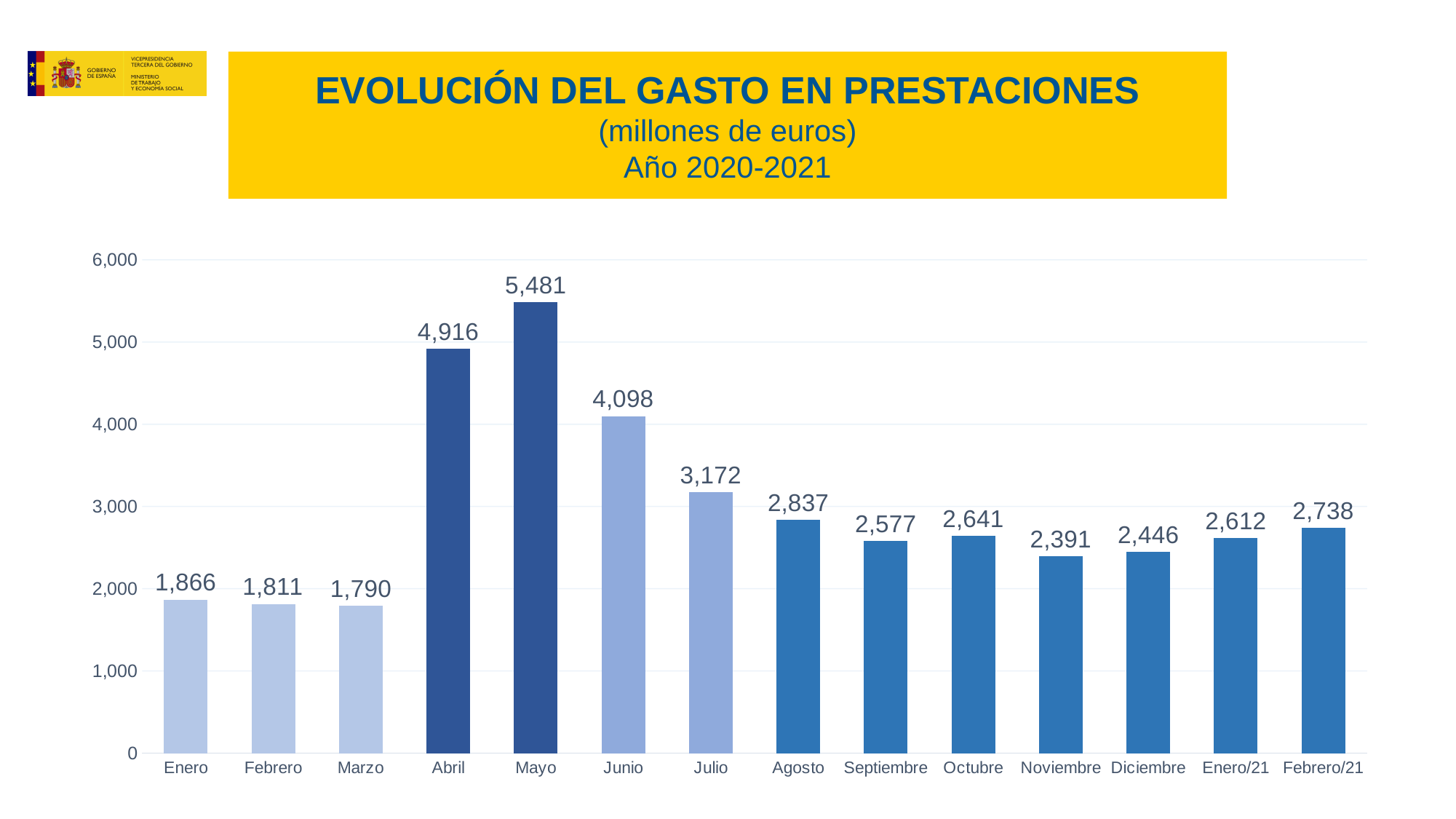
What is the difference between the values for Febrero/21 and Enero/21? 126 Which month has the lowest value? Marzo Is the value for Julio greater or less than 3,000? greater Which month has the highest value? Mayo What kind of chart is shown on the slide? bar chart What is the value for Noviembre? 2,391 What is the value for Febrero/21? 2,738 How many months are shown on the x axis? 14 What is the difference between the values for Mayo and Abril? 565 Do the values rise or fall from Mayo to Noviembre? fall What is the value for Mayo? 5,481 Which is larger, the value for Agosto or the value for Octubre? Agosto